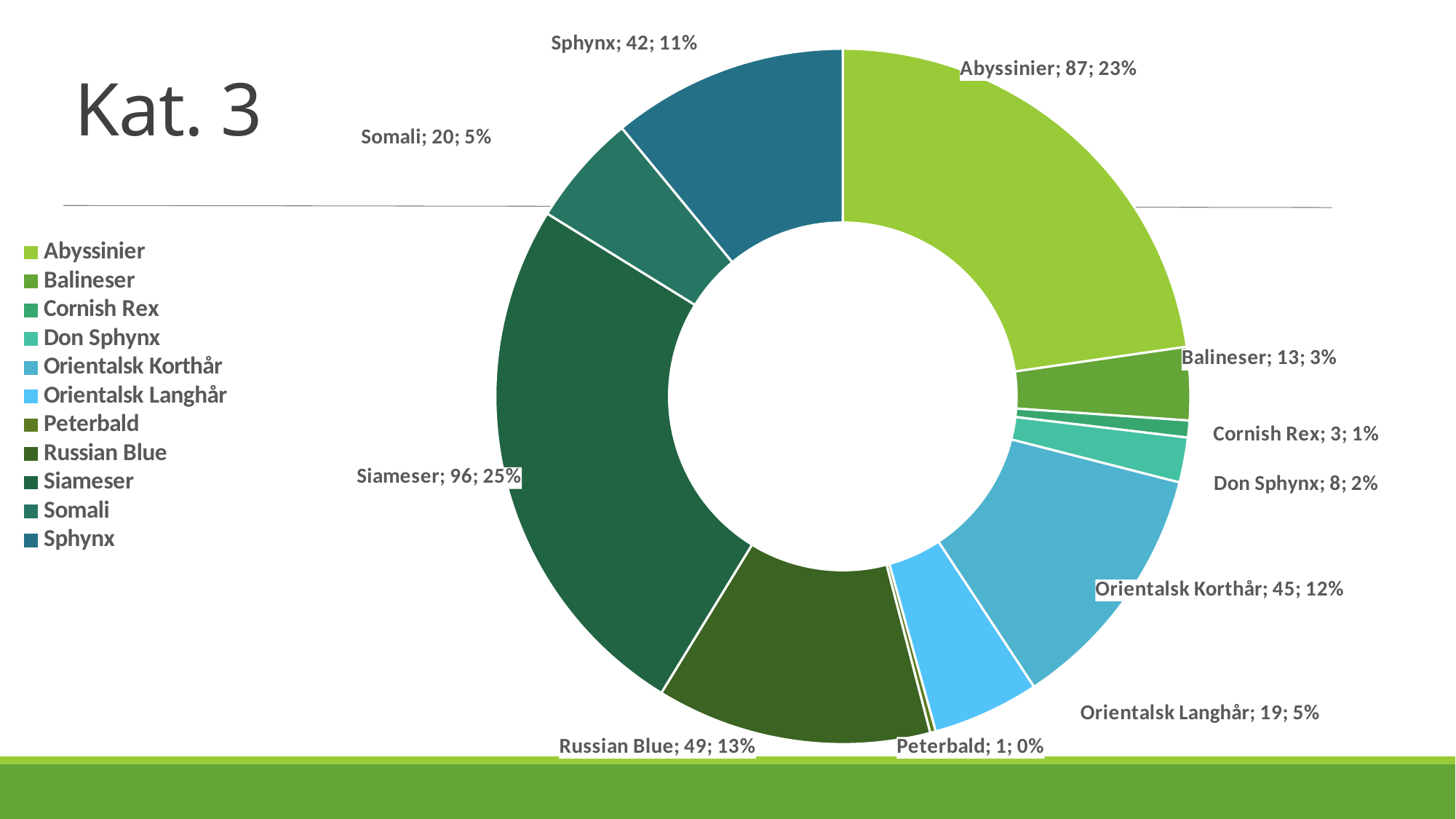
What is the title of the slide? Kat. 3 Which category has the largest slice? Siameser What is the difference between the values for Somali and Orientalsk Langhår? 1 What kind of chart is shown on the slide? Pie chart (doughnut) What percentage share is shown for Abyssinier? 23% What value is shown for Don Sphynx? 8 What is the difference between the values for Siameser and Abyssinier? 9 Which is larger, the value for Sphynx or the value for Orientalsk Korthår? Orientalsk Korthår What percentage share is shown for Russian Blue? 13% How many categories does the chart show? 11 What value is shown for Siameser? 96 Which category has the smallest slice? Peterbald